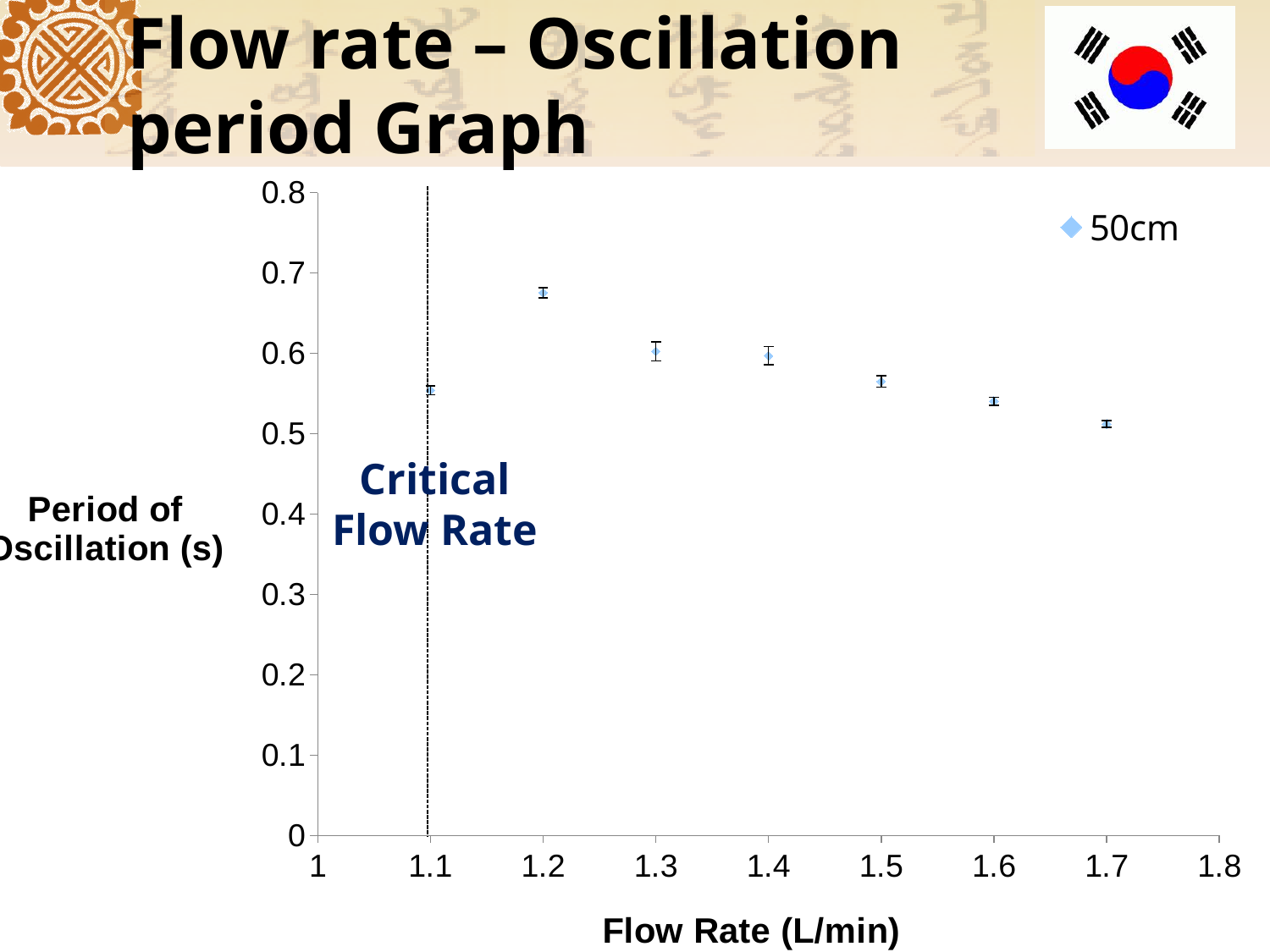
Is the period of oscillation at a flow rate of 1.2 L/min greater or less than 0.6? greater Which has a larger period of oscillation: flow rate 1.5 or flow rate 1.6? 1.5 Which has a larger period of oscillation: flow rate 1.2 or flow rate 1.7? 1.2 From a flow rate of 1.2 to 1.7 L/min, does the period of oscillation rise or fall? fall Is the period of oscillation at a flow rate of 1.1 L/min greater or less than 0.5? greater What kind of chart is shown on the slide? Scatter plot How many series does the legend list? 1 At which flow rate is the period of oscillation highest? 1.2 At which flow rate is the period of oscillation lowest? 1.7 What label is given to the dashed vertical line at a flow rate of 1.1 L/min? Critical Flow Rate Is the period of oscillation at a flow rate of 1.7 L/min greater or less than 0.6? less How many data points are plotted for the 50cm series? 7